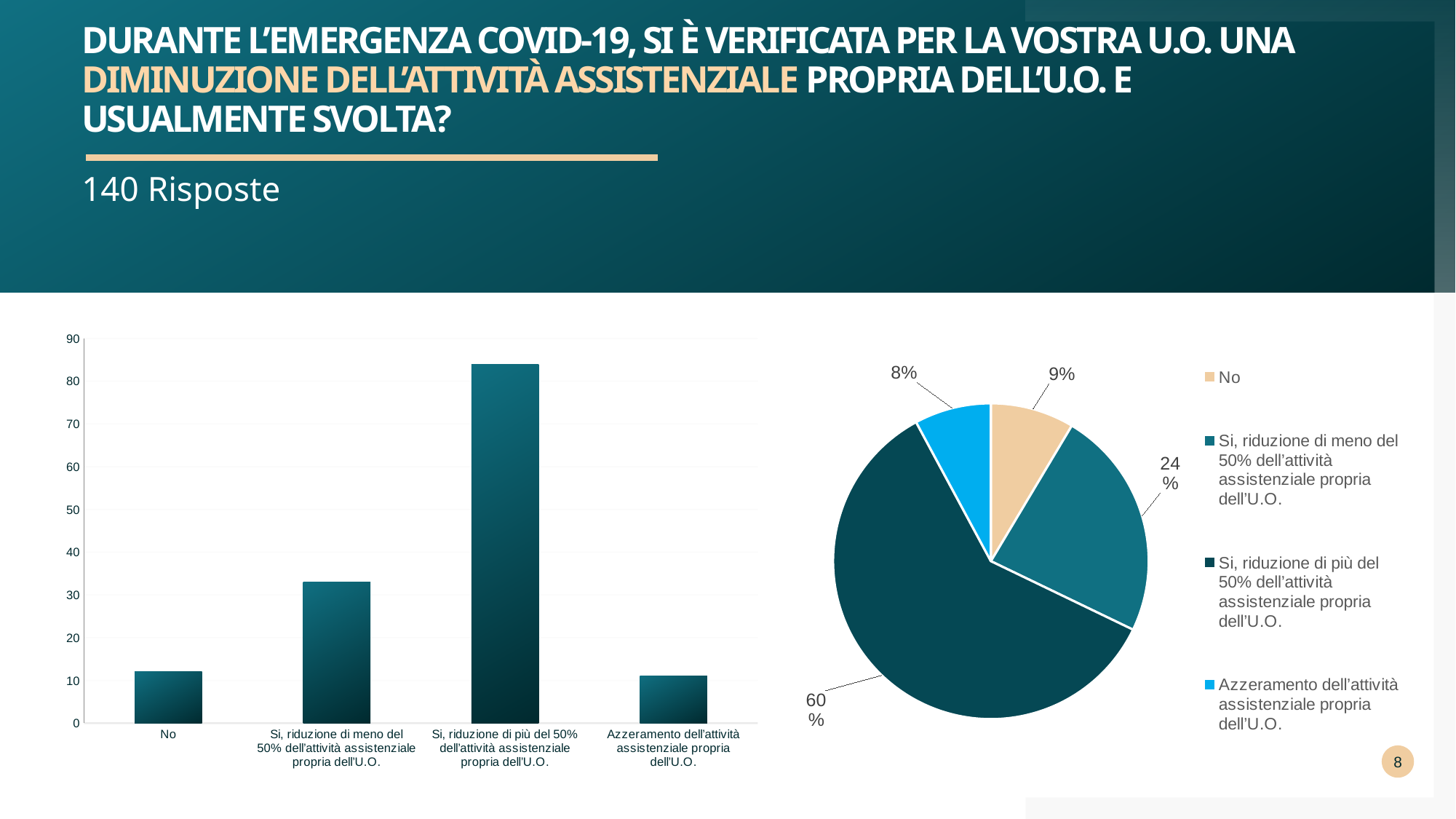
In the bar chart on the left, which is larger: the bar for 'No' or the bar for 'Si, riduzione di meno del 50% dell'attività assistenziale propria dell'U.O.'? Si, riduzione di meno del 50% dell'attività assistenziale propria dell'U.O. In the bar chart on the left, is the value for 'Si, riduzione di meno del 50% dell'attività assistenziale propria dell'U.O.' greater or less than 30? greater In the pie chart on the right, what share is shown for 'Si, riduzione di più del 50% dell'attività assistenziale propria dell'U.O.'? 60% In the pie chart on the right, what is the difference between the share for 'Si, riduzione di più del 50%' and the share for 'Si, riduzione di meno del 50%'? 36% In the bar chart on the left, is the value for 'No' greater or less than 20? less What kind of chart is the chart on the left of the slide? bar chart In the pie chart on the right, what percentage is shown for 'No'? 9% In the bar chart on the left, is the value for 'Si, riduzione di più del 50% dell'attività assistenziale propria dell'U.O.' greater or less than 80? greater In the bar chart on the left, how many categories are shown on the x axis? 4 In the pie chart on the right, which category has the smallest slice? Azzeramento dell'attività assistenziale propria dell'U.O. What kind of chart is the chart on the right of the slide? pie chart In the bar chart on the left, which category has the highest bar? Si, riduzione di più del 50% dell'attività assistenziale propria dell'U.O.